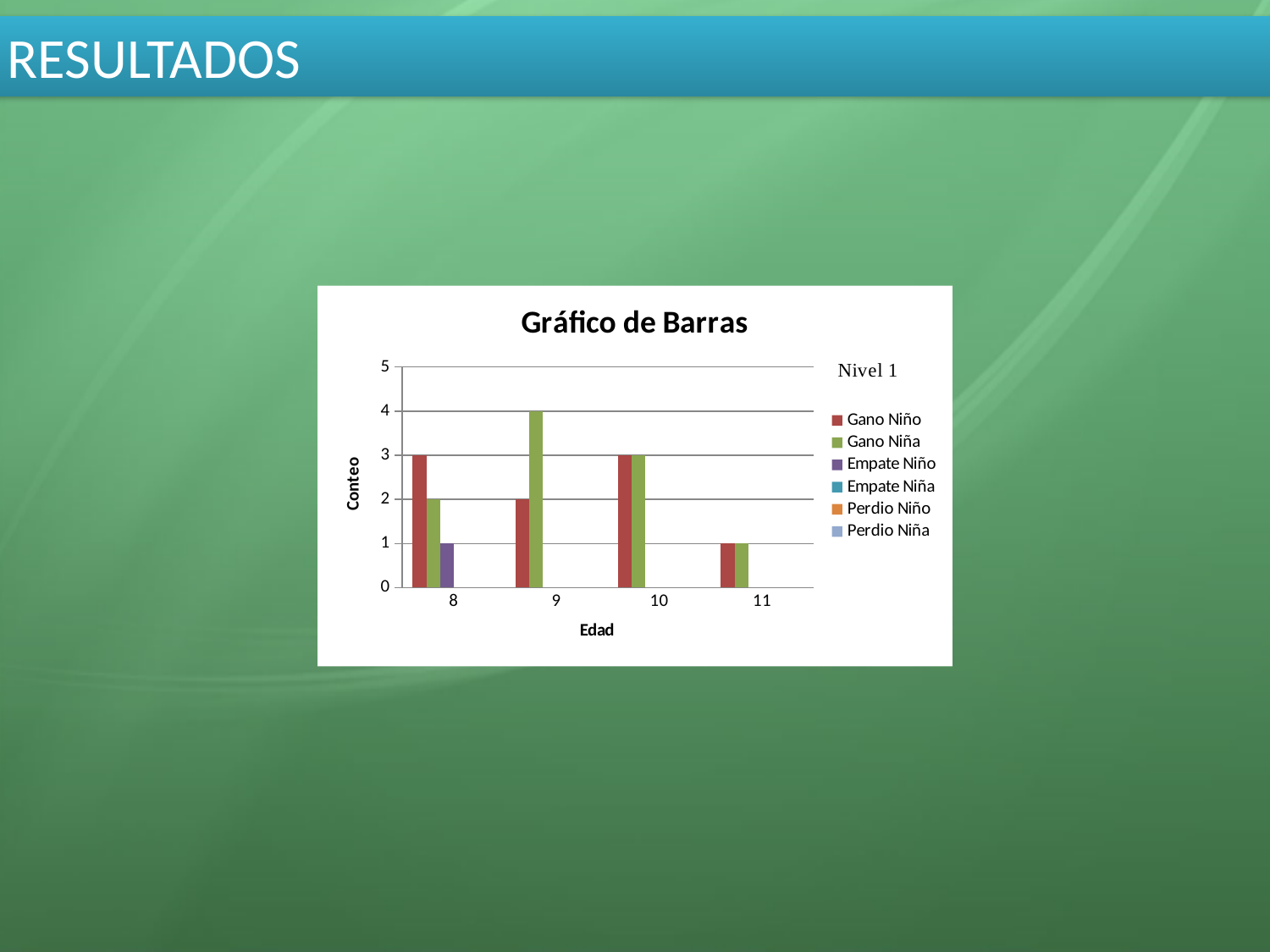
For age 8, which is larger: Gano Niño or Gano Niña? Gano Niño What is the title of the chart? Gráfico de Barras How many age categories are shown on the x axis of the chart? 4 What is the difference between Gano Niña and Gano Niño for age 9? 2 How many series does the legend of the chart list? 6 What kind of chart is shown on the slide? bar chart Does the Gano Niño value rise or fall from age 10 to age 11? fall What is the value of Gano Niño for age 8? 3 For which age is the Gano Niña value highest? 9 What is the value of Gano Niña for age 9? 4 What is the value of Empate Niño for age 8? 1 For which age is the Gano Niño value lowest? 11